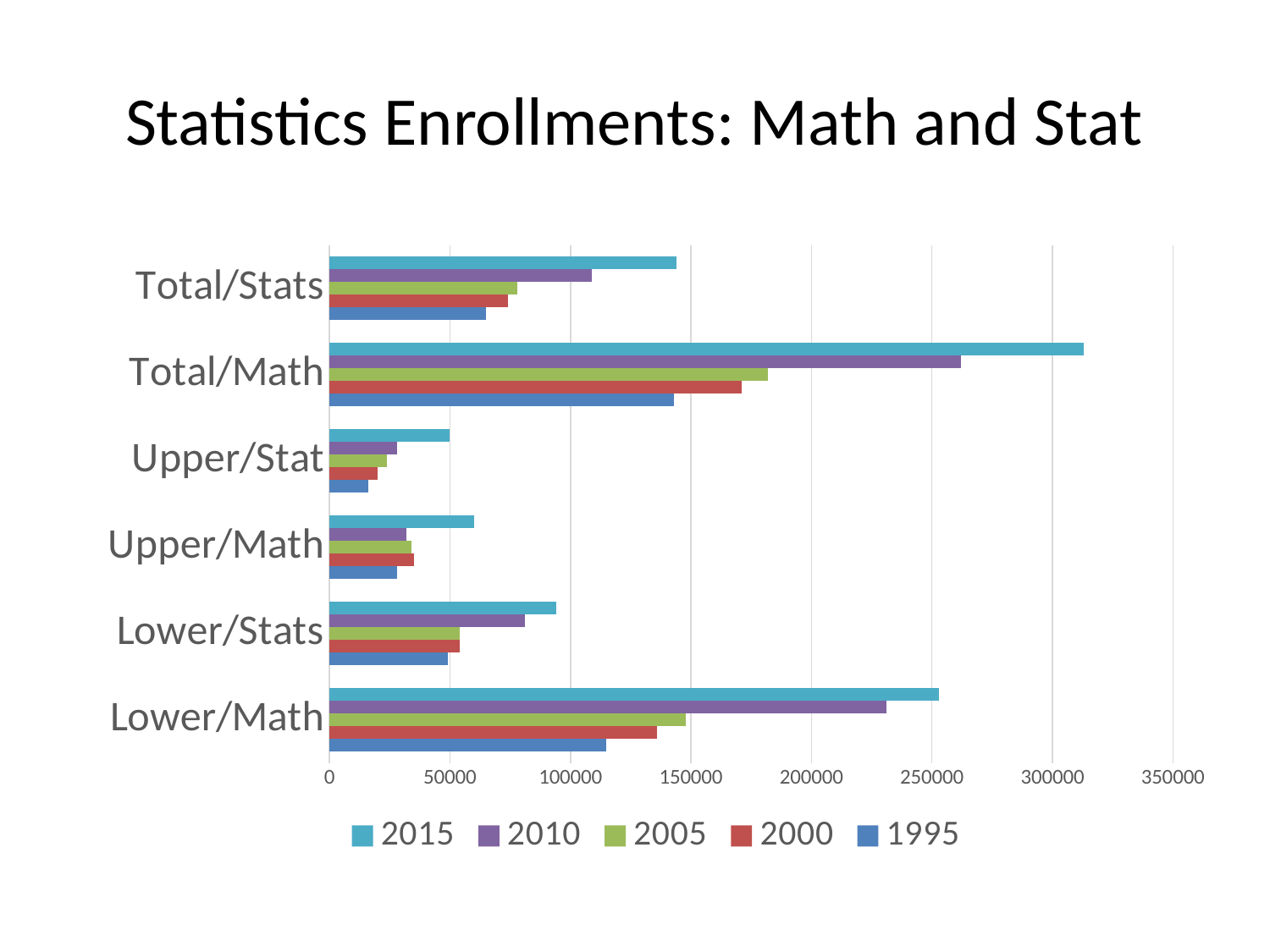
What is the title of the chart? Statistics Enrollments: Math and Stat Which category has the lowest value for 2015? Upper/Stat Which is larger: the 2015 value for Total/Stats or the 2015 value for Lower/Stats? Total/Stats How many categories are shown on the vertical axis? 6 What kind of chart is shown on the slide? bar chart For Total/Math, do the values rise or fall from 1995 to 2015? rise Is the 2015 value for Upper/Stat greater or less than 100000? less Is the 1995 value for Lower/Math greater or less than 100000? greater Which category has the highest value for 2015? Total/Math How many series does the legend list? 5 Which is larger: the 2010 value for Lower/Math or the 2015 value for Total/Stats? Lower/Math 2010 Is the 2015 value for Total/Math greater or less than 300000? greater